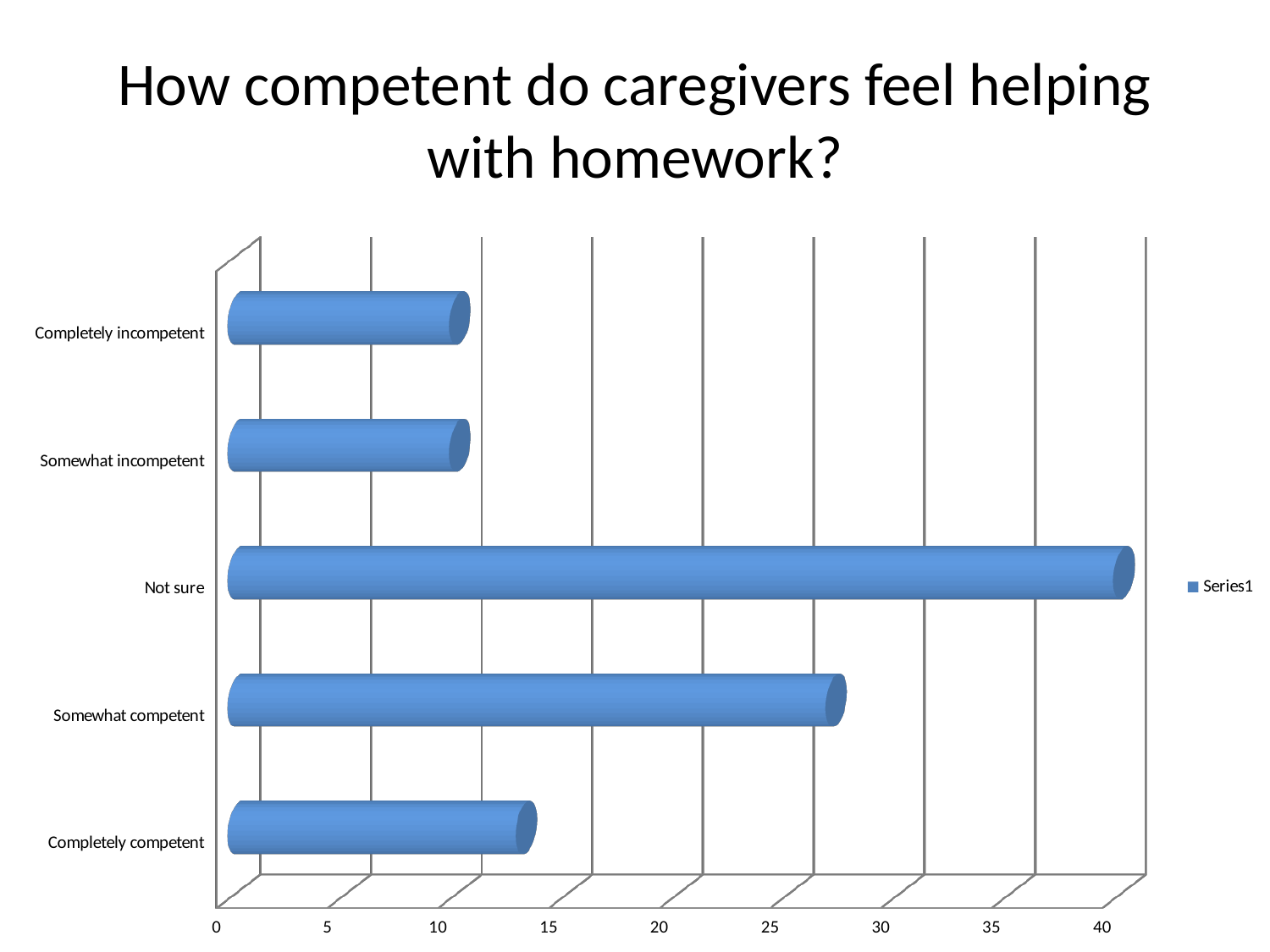
Is the value for Not sure greater or less than 35? greater How many categories are shown on the chart? 5 What kind of chart is shown on the slide? bar chart Which is larger, the value for Completely competent or the value for Completely incompetent? Completely competent Is the value for Completely competent greater or less than 15? less Is the value for Completely incompetent greater or less than 15? less Which category has the highest value? Not sure How many series does the legend list? 1 What is the title of the slide? How competent do caregivers feel helping with homework? Which is larger, the value for Somewhat competent or the value for Completely competent? Somewhat competent